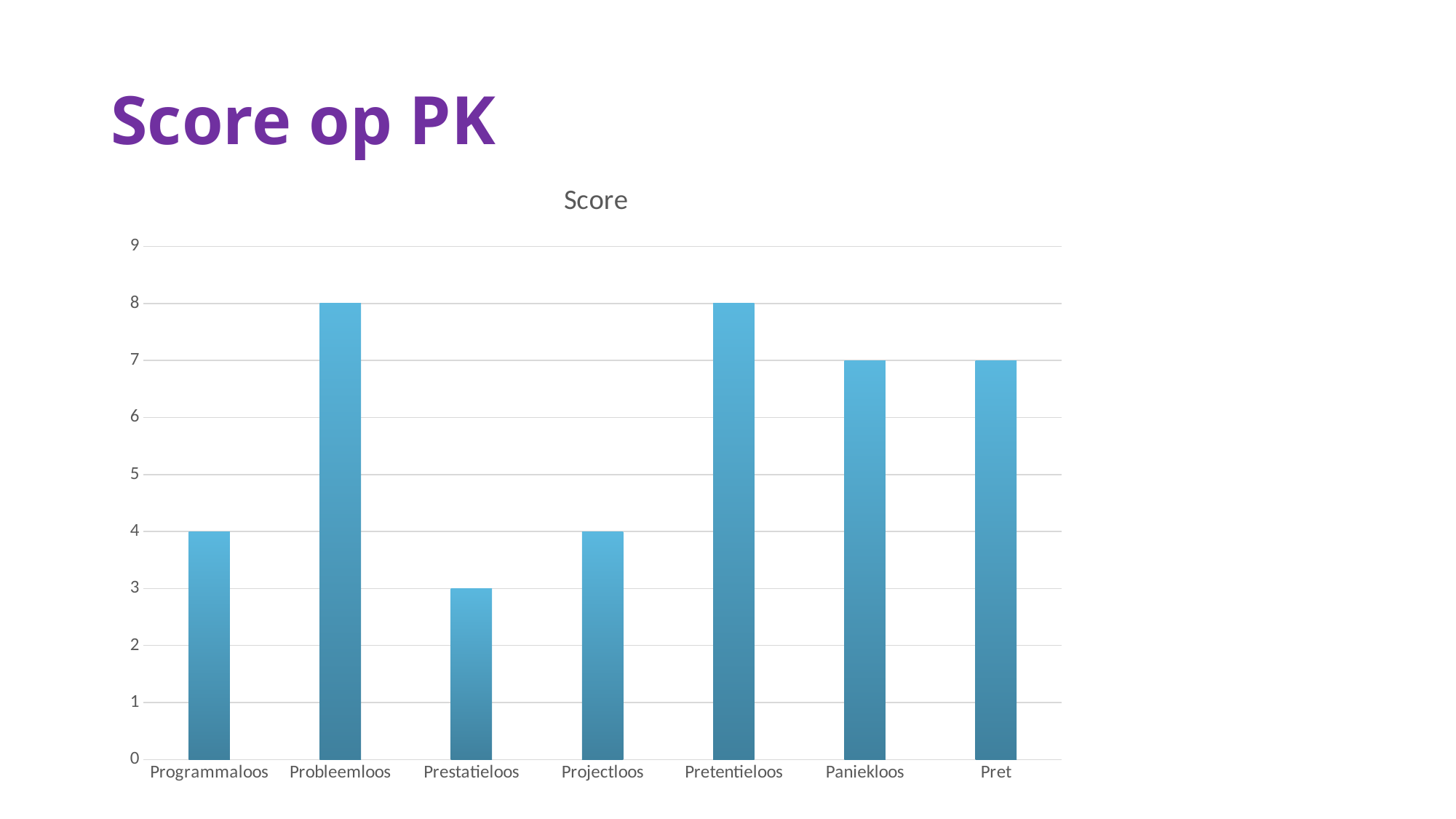
Which has a higher score, Paniekloos or Programmaloos? Paniekloos What is the difference between the scores for Probleemloos and Prestatieloos? 5 What is the score for Programmaloos? 4 What is the score for Pretentieloos? 8 What is the score for Prestatieloos? 3 What is the title of the chart? Score Is the score for Projectloos greater or less than 5? less What is the score for Paniekloos? 7 What kind of chart is shown on the slide? bar chart How many categories are shown on the x axis? 7 What is the difference between the scores for Pret and Projectloos? 3 Which category has the lowest score? Prestatieloos